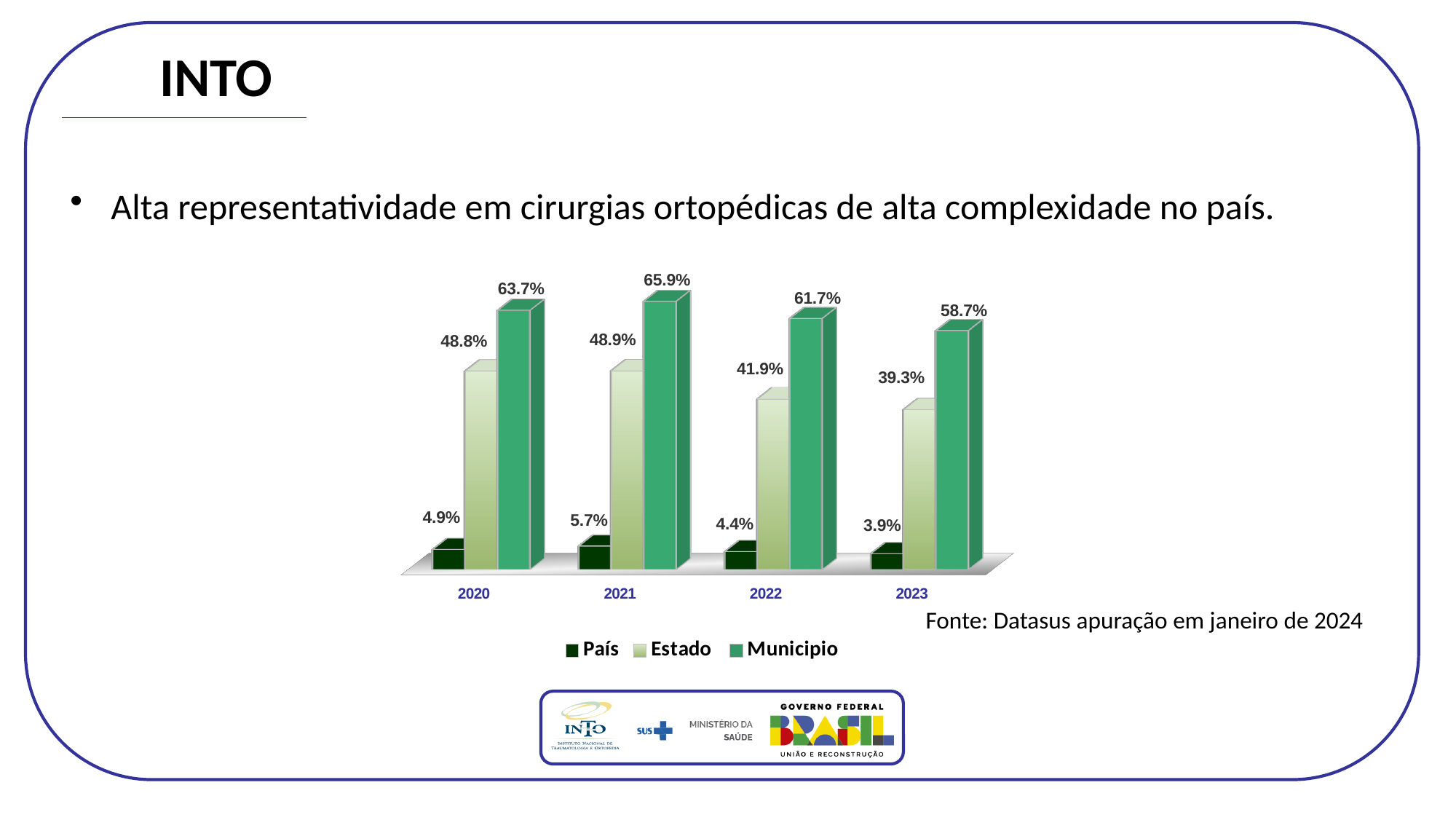
In which year is the País value lowest? 2023 In which year is the Municipio value highest? 2021 What are the three series listed in the legend? País, Estado, Municipio What is the difference between the Municipio and Estado values in 2022? 19.8% What is the value for Municipio in 2021? 65.9% What is the value for País in 2020? 4.9% What is the value for Estado in 2023? 39.3% Which is larger, the Estado value in 2020 or the Estado value in 2023? Estado in 2020 How many years are shown on the x axis? 4 Does the Estado value rise or fall from 2021 to 2023? Fall What kind of chart is shown on the slide? Bar chart How many series does the legend list? 3